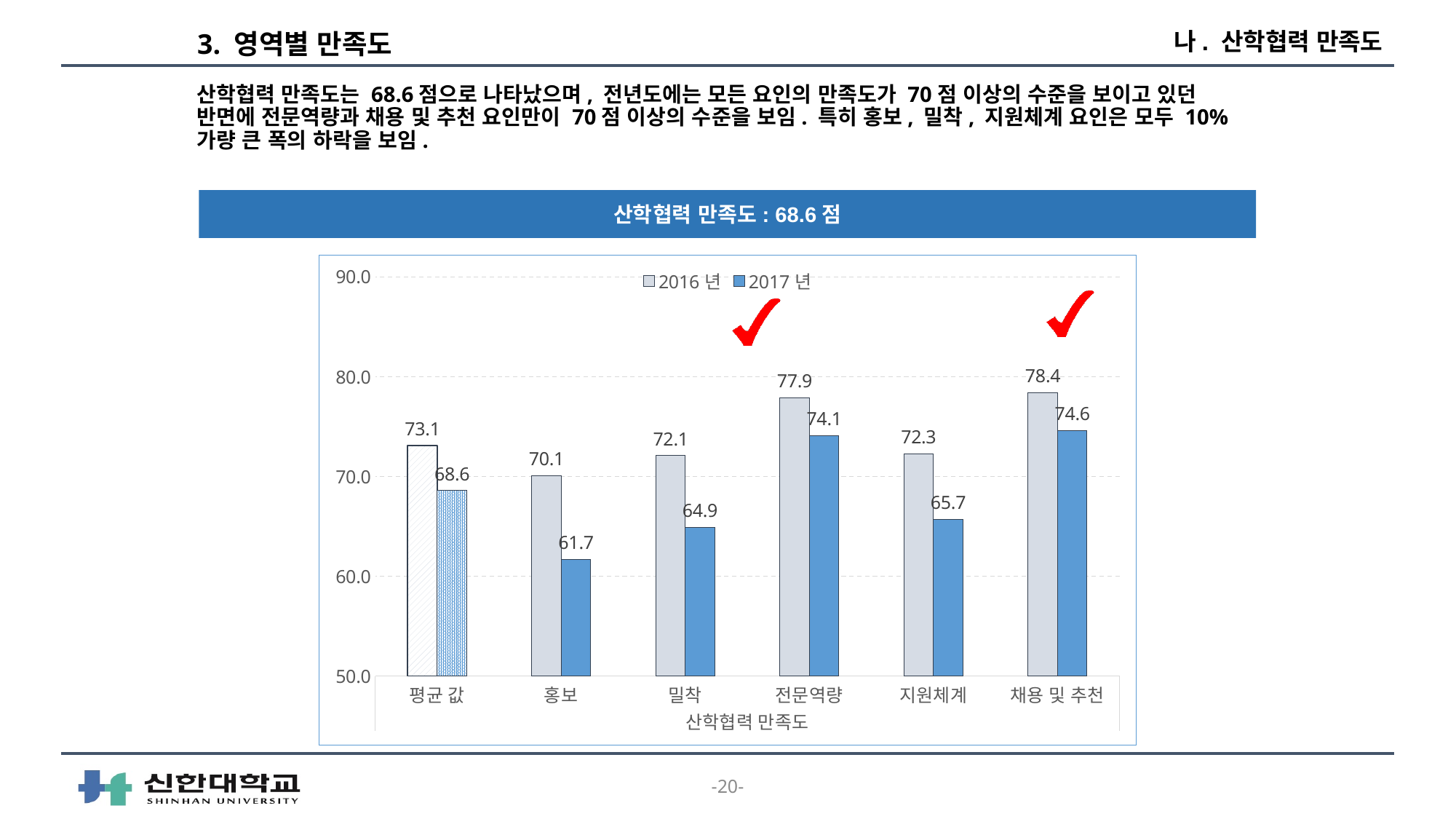
What kind of chart is shown on the slide? bar chart How many series does the legend list? 2 Which category has the lowest 2016 년 value? 홍보 What is the 2017 년 value for 지원체계? 65.7 What is the difference between the 2016 년 and 2017 년 values for 밀착? 7.2 Which category has the highest 2017 년 value? 채용 및 추천 What is the 2016 년 value for 전문역량? 77.9 Which is larger, the 2017 년 value for 전문역량 or the 2017 년 value for 채용 및 추천? 채용 및 추천 What is the 2017 년 value for 홍보? 61.7 Is the 2017 년 value for 홍보 greater or less than 70.0? less What is the 2016 년 value for 평균 값? 73.1 How many categories are shown on the x axis? 6